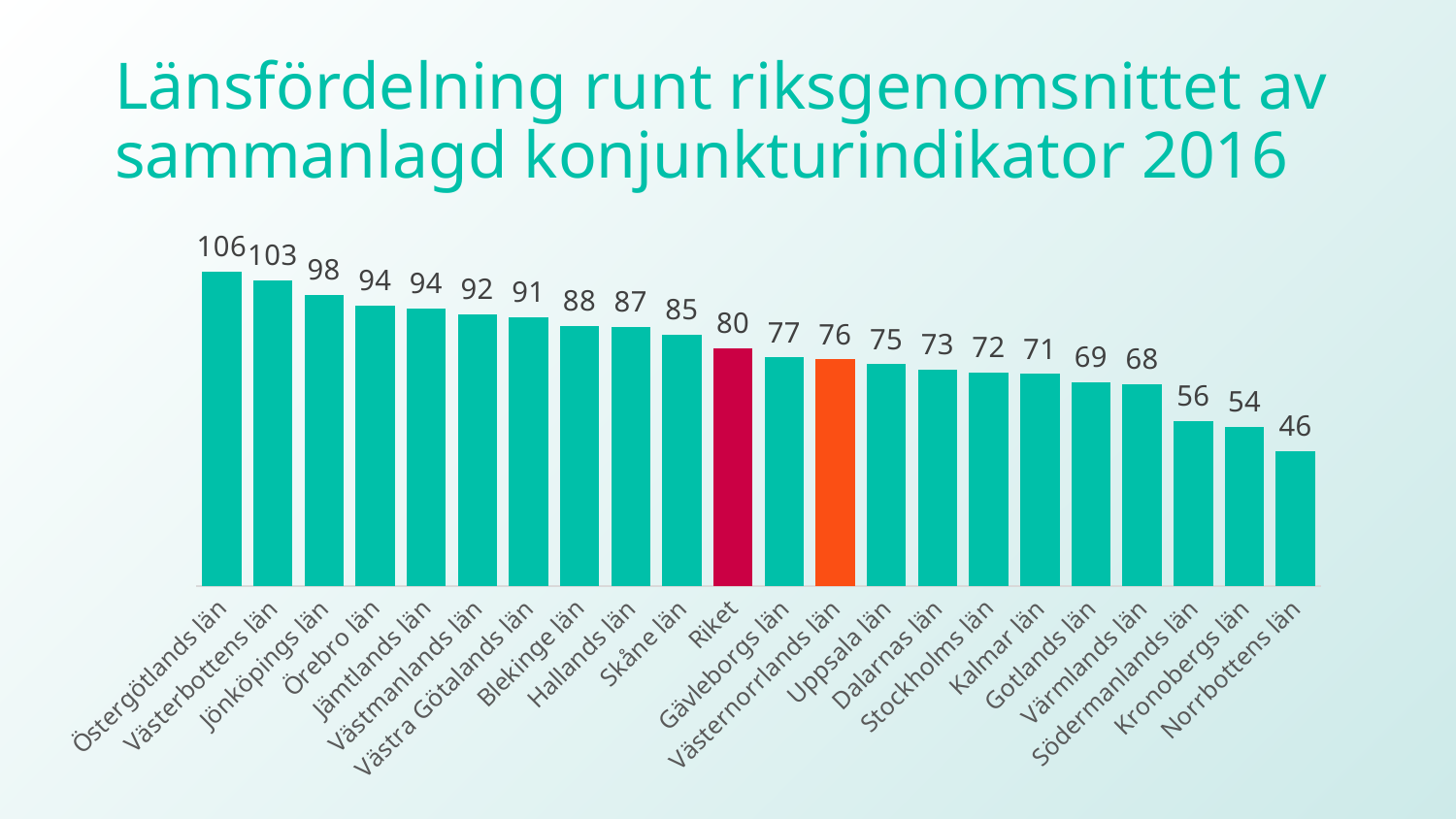
What is the difference between the values for Östergötlands län and Norrbottens län? 60 Which category has the lowest value? Norrbottens län What is the value for Västernorrlands län? 76 Which category has the highest value? Östergötlands län Which bar is coloured red rather than teal? Riket What is the value for Stockholms län? 72 What is the difference between the values for Riket and Skåne län? 5 Do the values rise or fall from left to right along the x axis? Fall How many categories are shown on the x axis? 22 Which is larger, the value for Uppsala län or the value for Gotlands län? Uppsala län What kind of chart is shown on the slide? Bar chart What is the value for Riket? 80